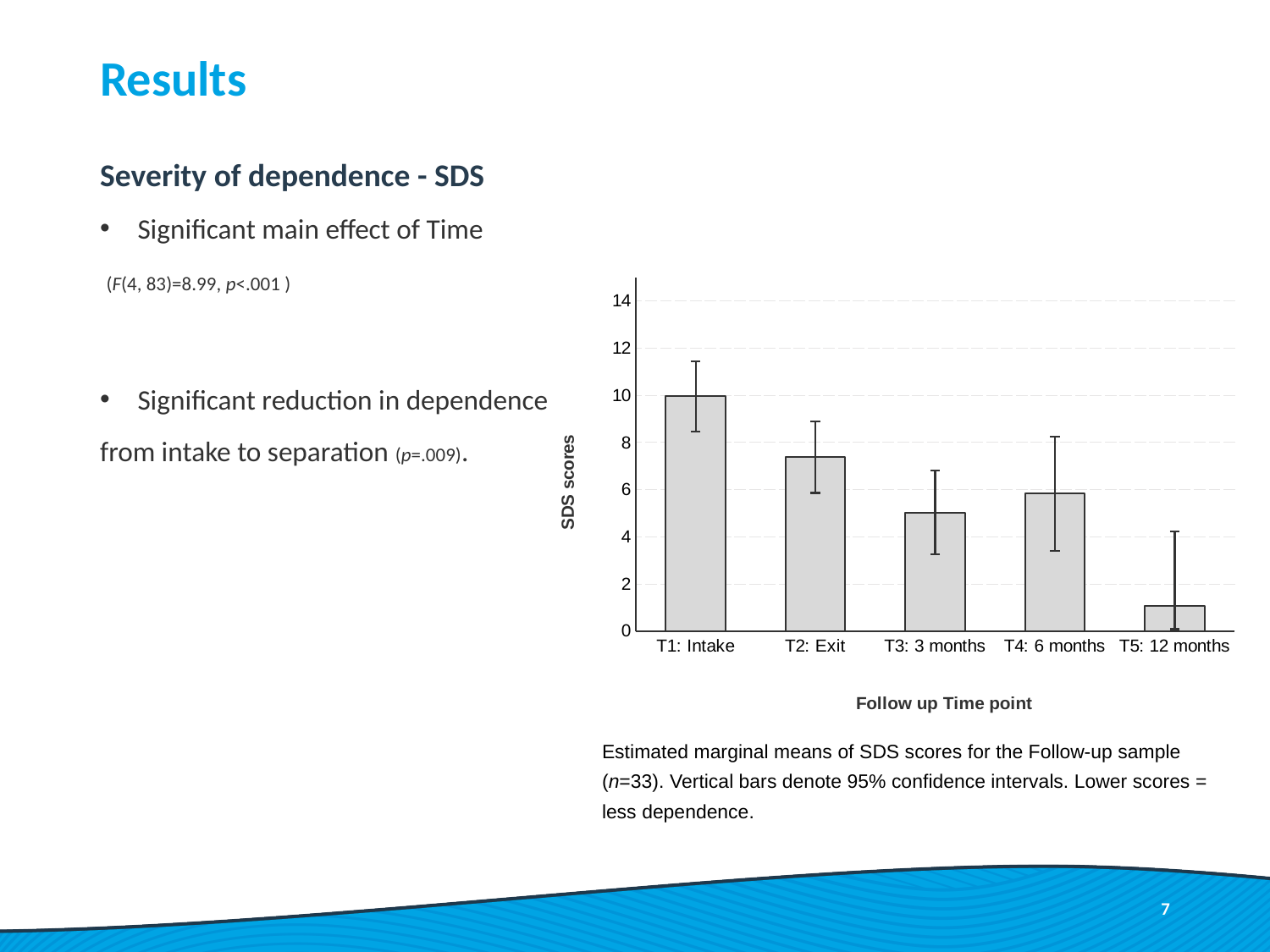
Is the SDS score for T1: Intake greater or less than 8? greater Do SDS scores generally rise or fall from T1: Intake to T5: 12 months? fall Is the SDS score for T5: 12 months greater or less than 2? less Which has a higher SDS score, T3: 3 months or T5: 12 months? T3: 3 months How many follow-up time points are plotted on the x axis? 5 Which time point has the lowest SDS score? T5: 12 months Is the SDS score for T2: Exit greater or less than 6? greater What kind of chart is shown on the slide? bar chart Which time point has the highest SDS score? T1: Intake What is the label of the y axis? SDS scores Which has a higher SDS score, T2: Exit or T4: 6 months? T2: Exit